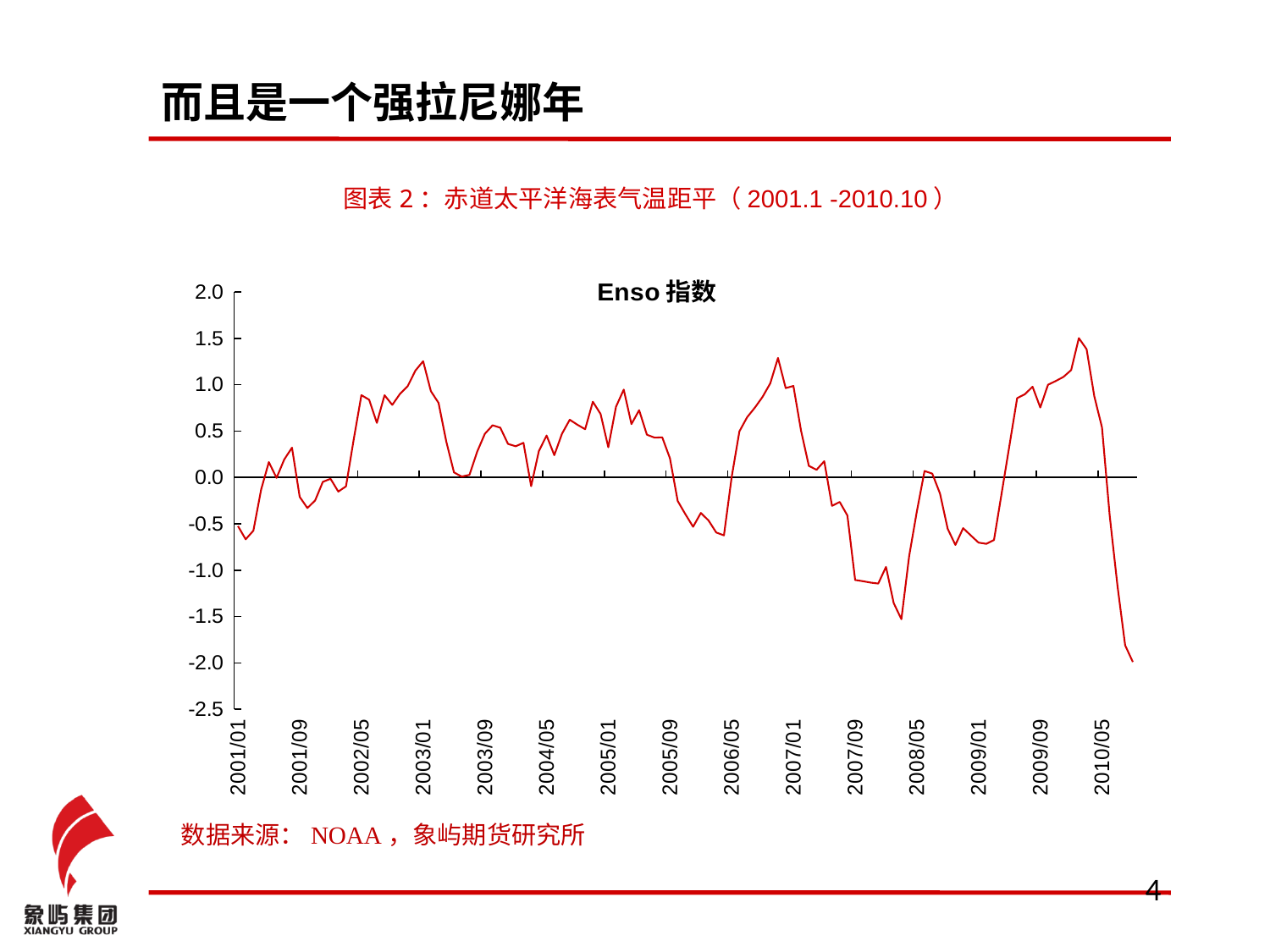
Does the line rise or fall between 2007/01 and 2007/09? fall What is the title printed inside the chart? Enso 指数 How many data series (lines) are plotted in the chart? 1 What is the lowest value shown on the y axis? -2.5 What kind of chart is shown on the slide? line chart Is the lowest value reached by the line greater or less than -1.5? less Is the value at 2003/01 greater or less than 1.0? greater Does the line rise or fall from 2010/05 to the end of the series? fall Is the value at 2009/09 greater or less than 0.5? greater